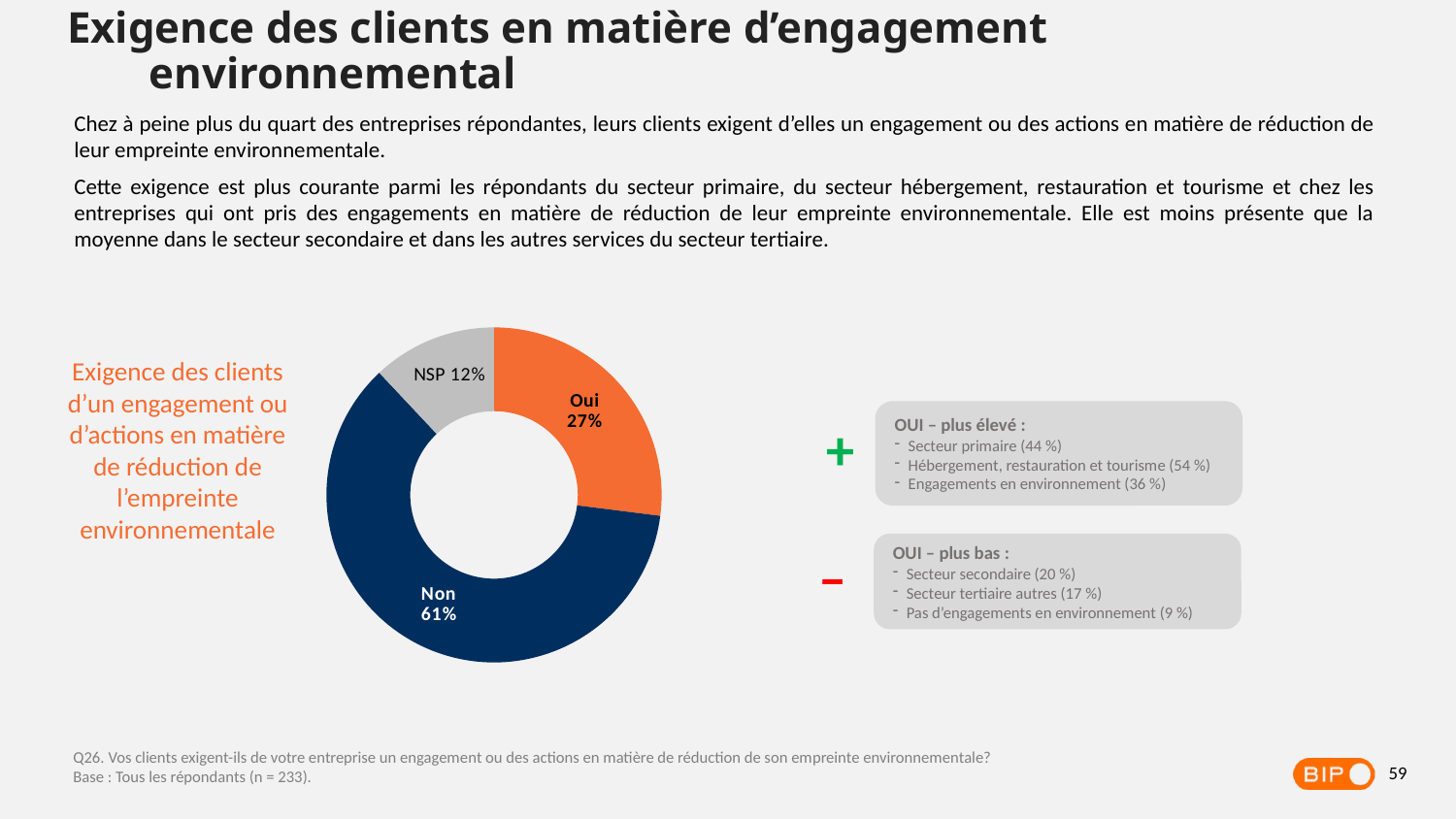
What percentage of respondents answered "Oui" in the donut chart? 27% Which category has the smallest share in the donut chart? NSP What percentage of respondents answered "Non" in the donut chart? 61% What colour is the "Non" slice in the donut chart? Dark blue Which is larger, the share for "Oui" or the share for "NSP"? Oui What is the difference in percentage points between the "Oui" and "NSP" shares? 15 What percentage of respondents answered "NSP" in the donut chart? 12% What colour is the "Oui" slice in the donut chart? Orange What is the difference in percentage points between the "Non" and "Oui" shares? 34 How many categories are shown in the donut chart? 3 What type of chart is shown on the slide? Donut (pie) chart Which category has the largest share in the donut chart? Non